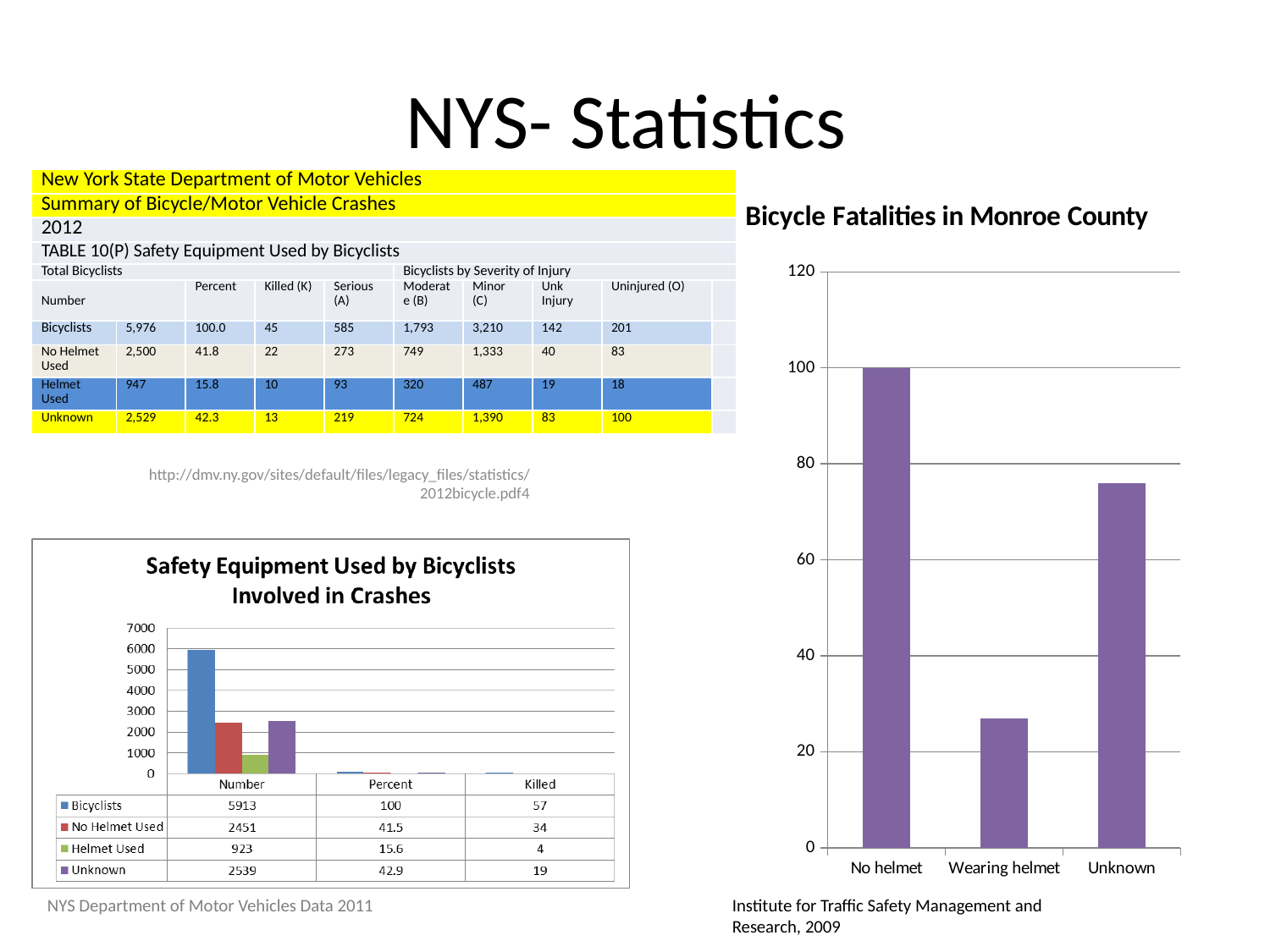
In the 'Safety Equipment Used by Bicyclists Involved in Crashes' chart, what is the Percent value for Helmet Used? 15.6 In the 'Safety Equipment Used by Bicyclists Involved in Crashes' chart, which series has the lowest Killed value? Helmet Used In the 'Bicycle Fatalities in Monroe County' chart, which category has the highest value? No helmet In the 'Safety Equipment Used by Bicyclists Involved in Crashes' chart, what is the Number value for Bicyclists? 5913 In the 'Bicycle Fatalities in Monroe County' chart, which category has the lowest value? Wearing helmet In the 'Bicycle Fatalities in Monroe County' chart, is the value for Unknown greater or less than 60? greater What kind of chart is 'Bicycle Fatalities in Monroe County'? bar chart How many categories are shown on the x axis of the 'Bicycle Fatalities in Monroe County' chart? 3 In the 'Safety Equipment Used by Bicyclists Involved in Crashes' chart, what is the difference between the Number values for Unknown and No Helmet Used? 88 In the 'Safety Equipment Used by Bicyclists Involved in Crashes' chart, what is the Killed value for No Helmet Used? 34 How many series does the legend of the 'Safety Equipment Used by Bicyclists Involved in Crashes' chart list? 4 In the 'Safety Equipment Used by Bicyclists Involved in Crashes' chart, which is larger, the Number for Unknown or the Number for Helmet Used? Unknown